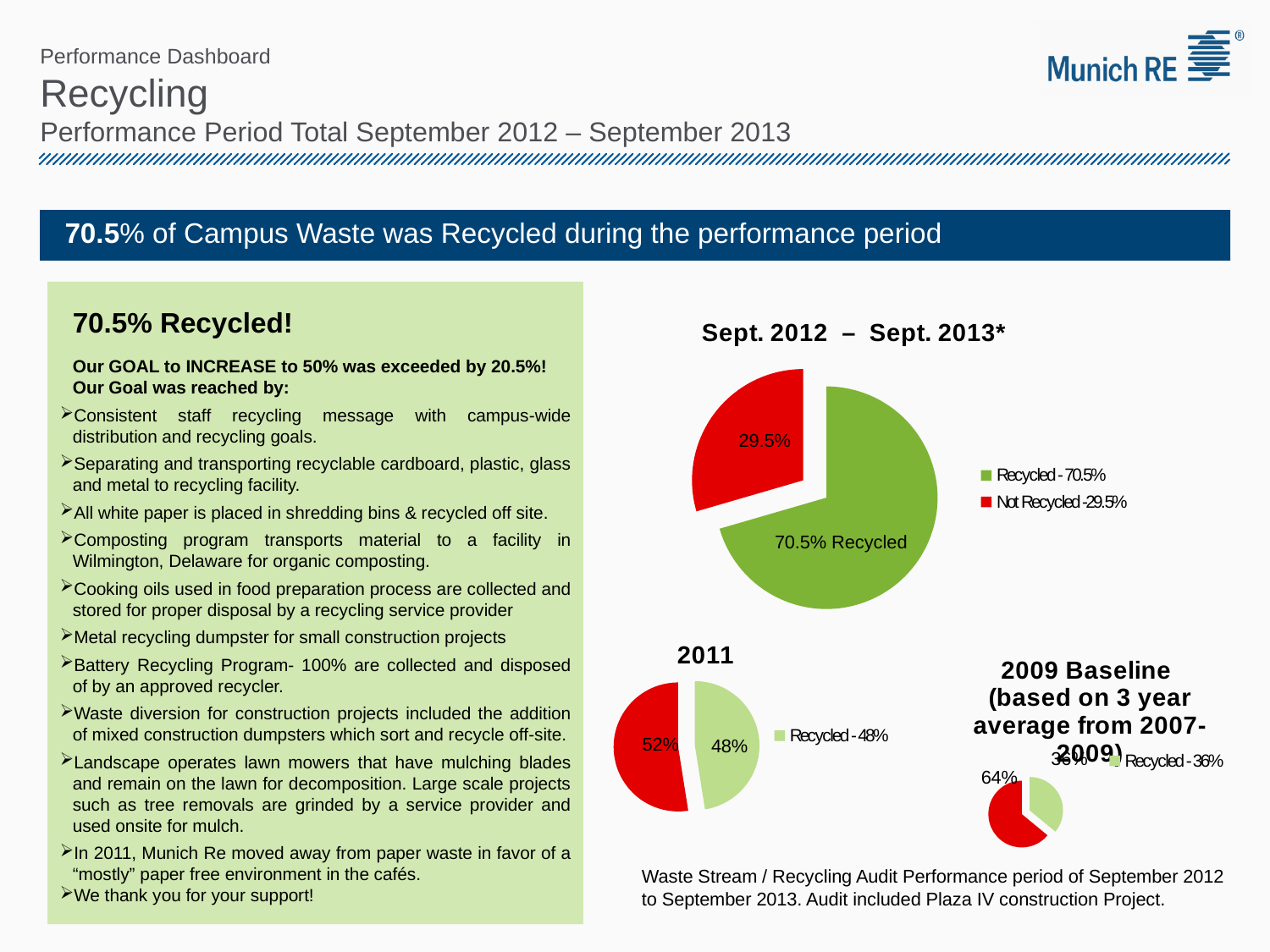
How many entries does the legend of the 'Sept. 2012 – Sept. 2013*' chart list? 2 Which colour represents 'Not Recycled' in the 'Sept. 2012 – Sept. 2013*' chart? Red In the 'Sept. 2012 – Sept. 2013*' chart, what is the difference between the Recycled and Not Recycled shares? 41% What kind of chart is the 'Sept. 2012 – Sept. 2013*' chart? Pie chart In the 'Sept. 2012 – Sept. 2013*' chart, what share of waste was recycled? 70.5% How many slices does the 'Sept. 2012 – Sept. 2013*' pie chart have? 2 In the 'Sept. 2012 – Sept. 2013*' chart, what share of waste was not recycled? 29.5% In the '2009 Baseline' pie chart, what is the value of the red slice? 64% In the '2011' pie chart, what share was recycled? 48% In the 'Sept. 2012 – Sept. 2013*' chart, which slice is larger, Recycled or Not Recycled? Recycled In the '2011' pie chart, what is the value of the red slice? 52% In the '2009 Baseline' pie chart, what share was recycled according to the legend? 36%